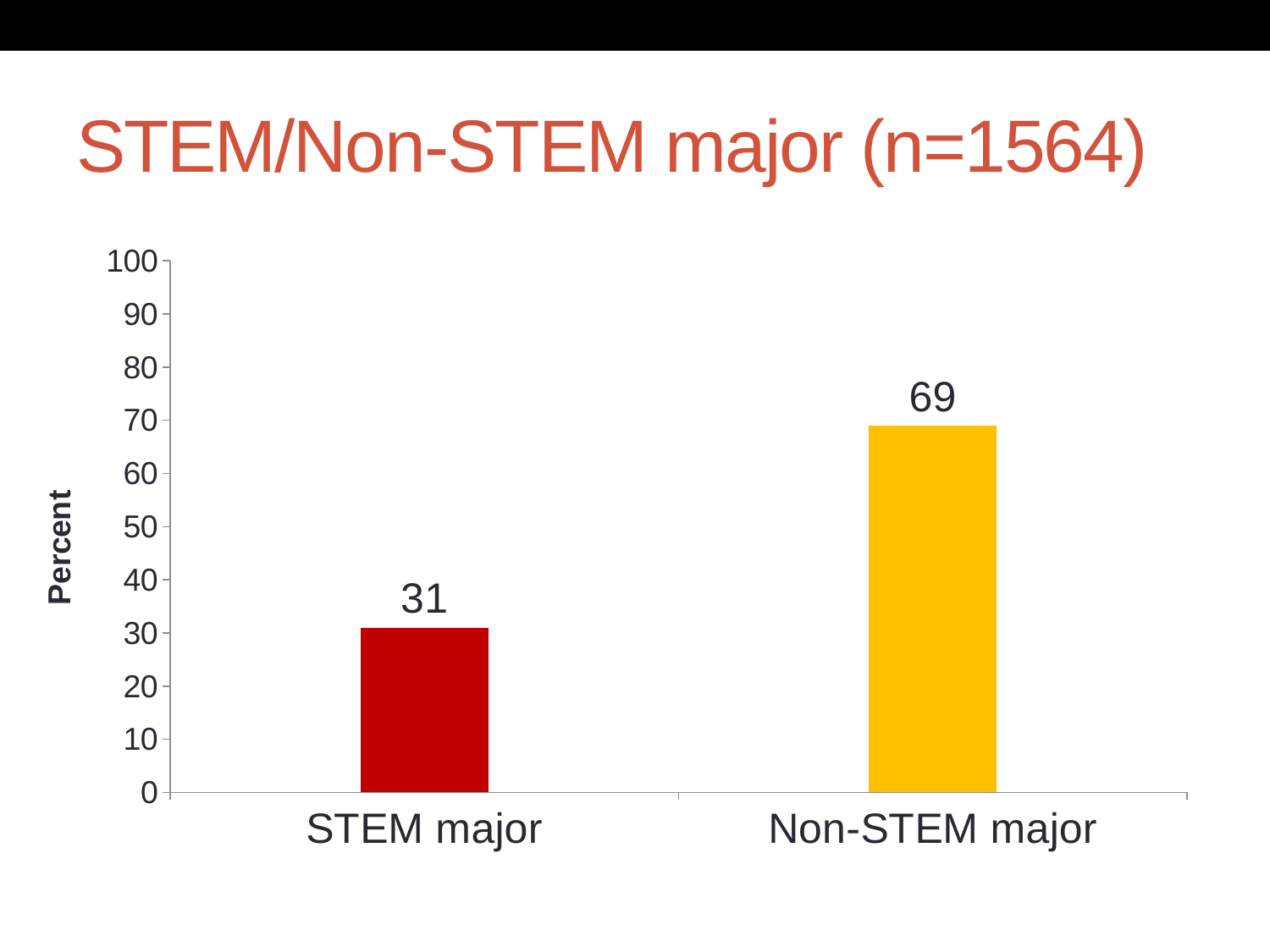
Which category has the highest value? Non-STEM major Which is larger, the value for STEM major or the value for Non-STEM major? Non-STEM major Is the value for STEM major greater or less than 40? less Which category has the lowest value? STEM major What is the difference between the values for Non-STEM major and STEM major? 38 Is the value for Non-STEM major greater or less than 60? greater What is the value for STEM major? 31 What is the label of the y axis? Percent What is the title of the slide? STEM/Non-STEM major (n=1564) What kind of chart is shown on the slide? bar chart How many categories are shown on the x axis? 2 What is the value for Non-STEM major? 69